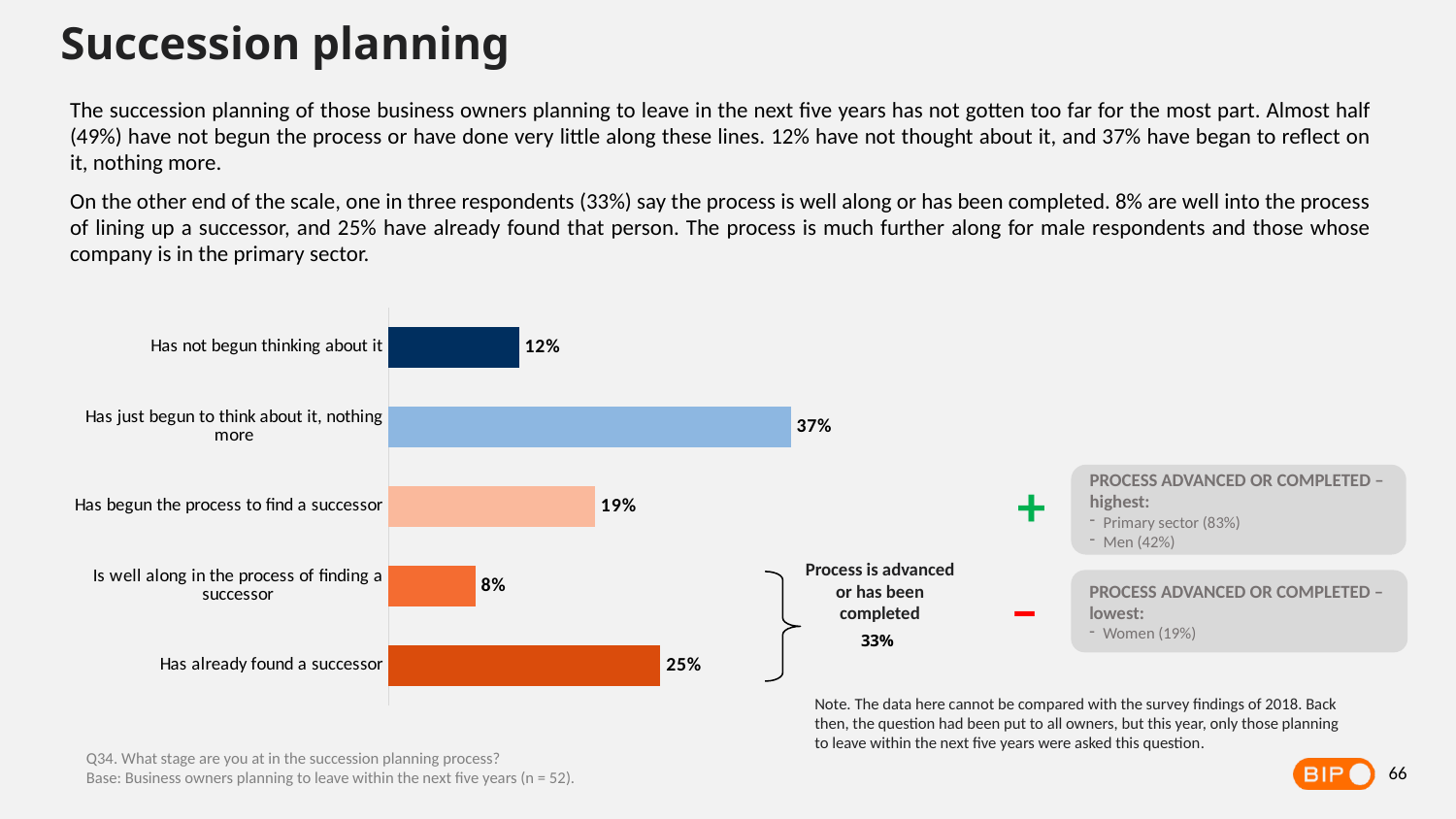
What kind of chart is shown on the slide? Bar chart What percentage of respondents have already found a successor? 25% What percentage of respondents have not begun thinking about succession planning? 12% What percentage of respondents have begun the process to find a successor? 19% How many categories are shown in the bar chart? 5 What is the combined total for 'Is well along in the process of finding a successor' and 'Has already found a successor', labelled as 'Process is advanced or has been completed'? 33% What percentage of respondents have just begun to think about it, nothing more? 37% What percentage of respondents are well along in the process of finding a successor? 8% Which category has the highest value in the chart? Has just begun to think about it, nothing more Which category has the lowest value in the chart? Is well along in the process of finding a successor Which is larger: the value for 'Has begun the process to find a successor' or the value for 'Has not begun thinking about it'? Has begun the process to find a successor What is the difference between the value for 'Has just begun to think about it, nothing more' and the value for 'Has already found a successor'? 12%